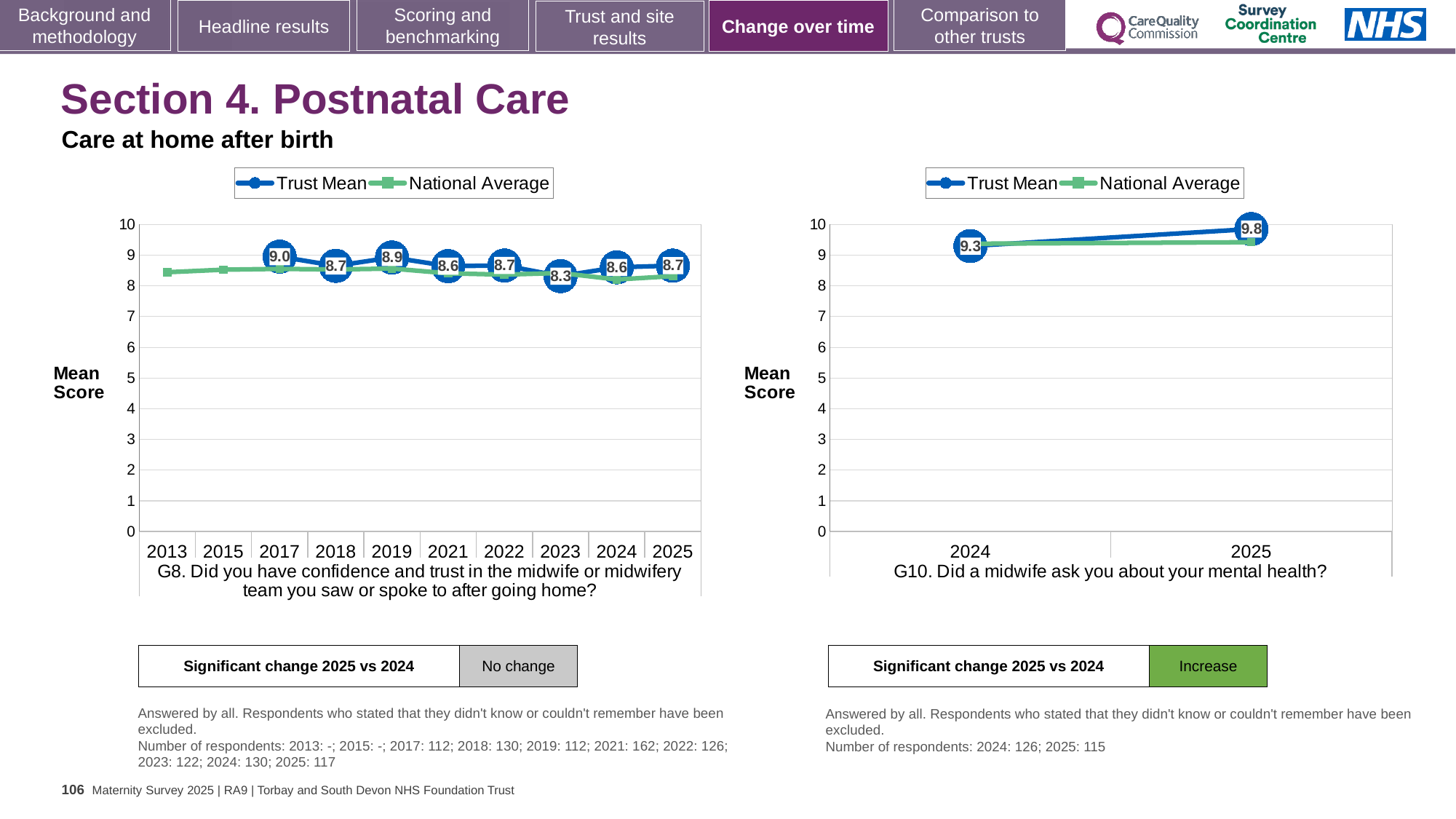
In the G10 chart on the right, by how much did the Trust Mean change from 2024 to 2025? 0.5 In the G8 chart on the left, which year has the lowest labelled Trust Mean? 2023 In the G8 chart on the left, which year has the highest labelled Trust Mean? 2017 In the G8 chart on the left, what is the Trust Mean for 2025? 8.7 In the G10 chart on the right, what is the Trust Mean for 2024? 9.3 In the G8 chart on the left, is the Trust Mean higher in 2019 or in 2021? 2019 In the G10 chart on the right, does the Trust Mean rise or fall from 2024 to 2025? rise In the G8 chart on the left, what is the Trust Mean for 2023? 8.3 How many series does the legend of the G10 chart on the right list? 2 In the G8 chart on the left, how many years are shown on the x axis? 10 In the G10 chart on the right, what is the Trust Mean for 2025? 9.8 In the G8 chart on the left, what is the difference between the Trust Mean in 2017 and in 2023? 0.7